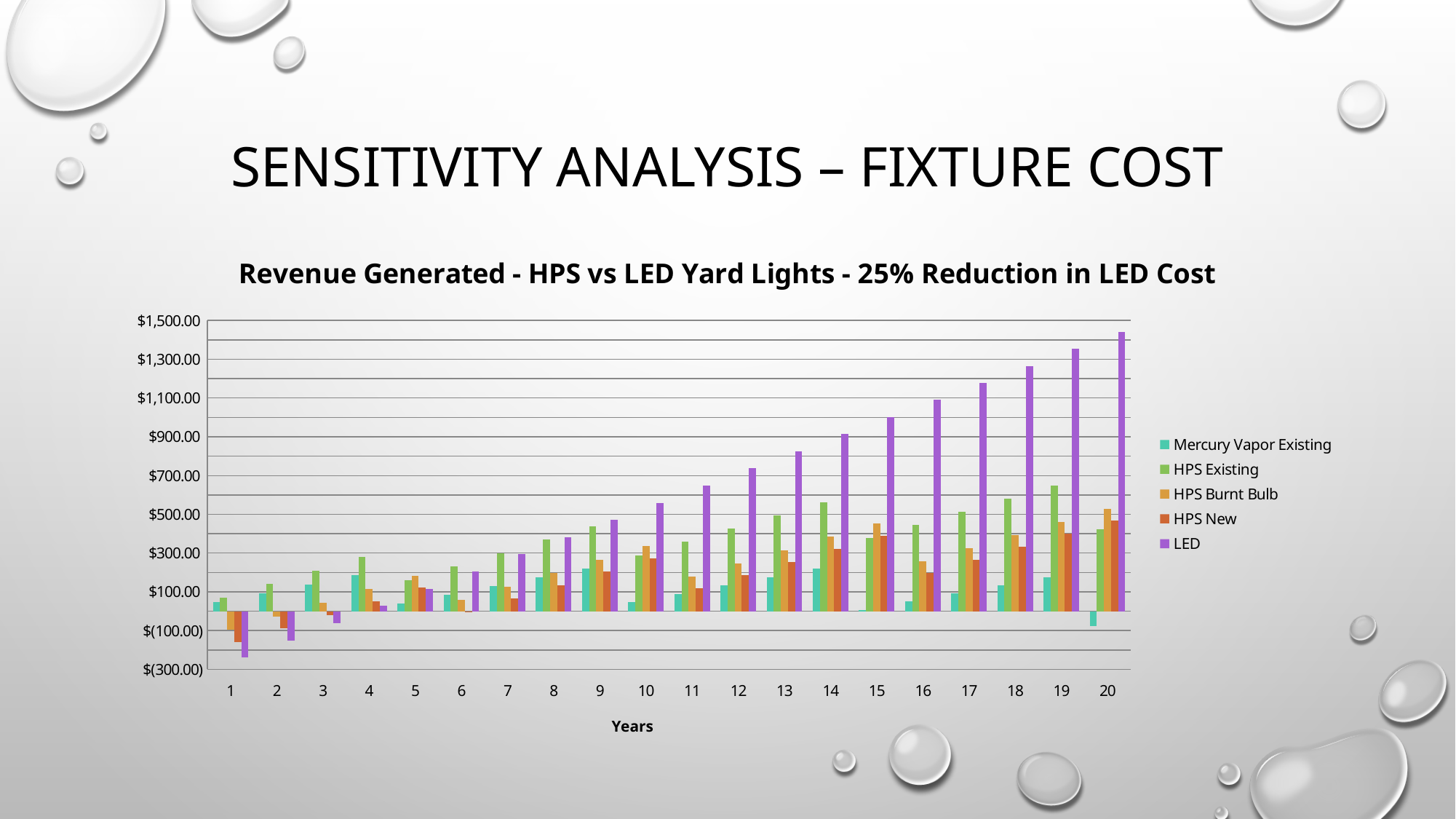
How many years are shown along the x axis? 20 Is the LED value for year 1 greater or less than $(100.00)? less How many series does the legend list? 5 Which series has the lowest value in year 1? LED What type of chart is shown on the slide? bar chart What is the label of the x axis? Years Is the HPS Existing value for year 20 greater or less than $300.00? greater Is the LED value for year 13 greater or less than $700.00? greater Which series has the highest value in year 20? LED What is the title of the chart? Revenue Generated - HPS vs LED Yard Lights - 25% Reduction in LED Cost In year 4, which is larger: HPS Existing or LED? HPS Existing